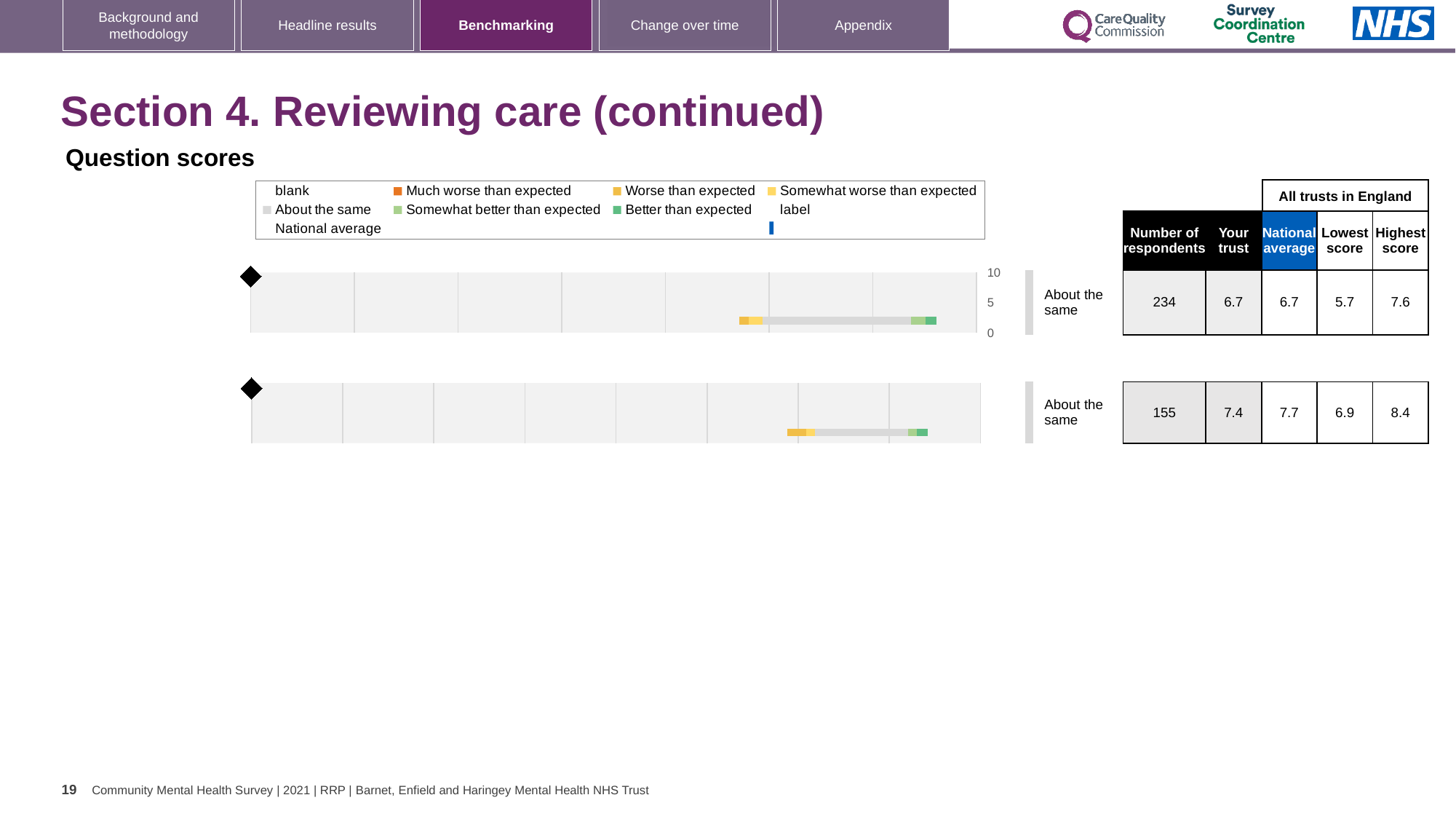
For the bottom chart's row, what is the difference between the highest score and the lowest score in the table? 1.5 What benchmark category label is shown next to the bottom chart? About the same In the table beside the bottom chart, what is the national average score? 7.7 In the table beside the top chart, what is the lowest score among all trusts in England? 5.7 How many benchmarking charts are shown on the slide? 2 What colour does the legend use for 'Better than expected'? green In the table beside the top chart, what is the number of respondents? 234 For the top chart's row, what is the difference between the highest score and the lowest score in the table? 1.9 What is the highest tick value shown on the vertical axis next to the top chart? 10 In the table beside the bottom chart, what is the 'Your trust' score? 7.4 What kind of chart is the top chart on the slide? bar chart Which has the larger 'Your trust' score, the top chart's row or the bottom chart's row? the bottom chart's row